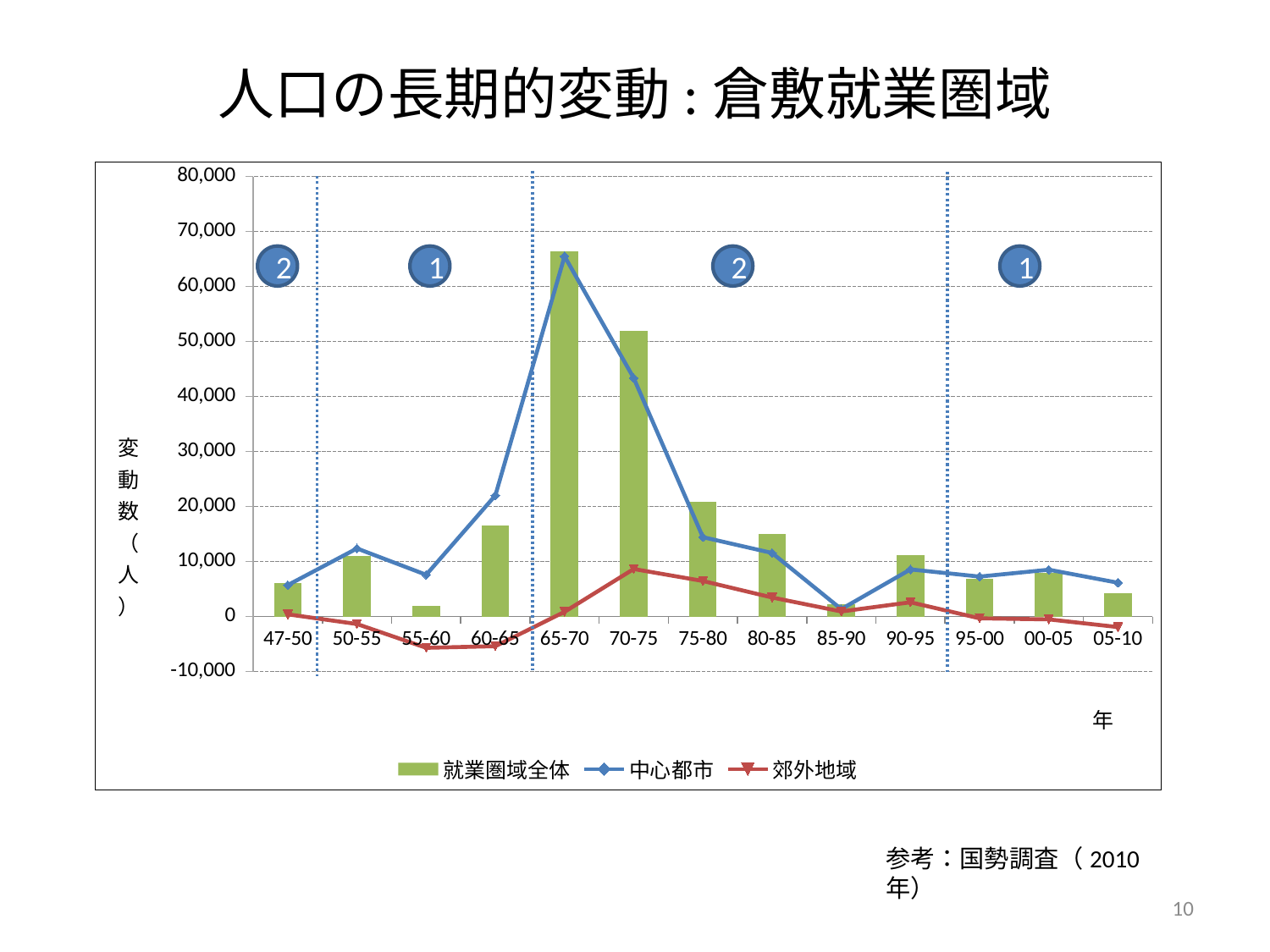
Which is larger, the 就業圏域全体 bar for 65-70 or for 70-75? 65-70 How many period categories are shown along the x axis? 13 What is the title of the chart on the slide? 人口の長期的変動：倉敷就業圏域 Is the 就業圏域全体 value for 70-75 greater or less than 50,000? greater Which series is drawn as bars in the chart? 就業圏域全体 In which period is the 就業圏域全体 bar the highest? 65-70 How many series does the chart's legend list? 3 Is the 就業圏域全体 value for 65-70 greater or less than 60,000? greater What kind of chart is shown on the slide? Combined bar and line chart Do the 就業圏域全体 bars rise or fall from 65-70 to 85-90? fall Is the 郊外地域 value for 55-60 greater or less than 0? less